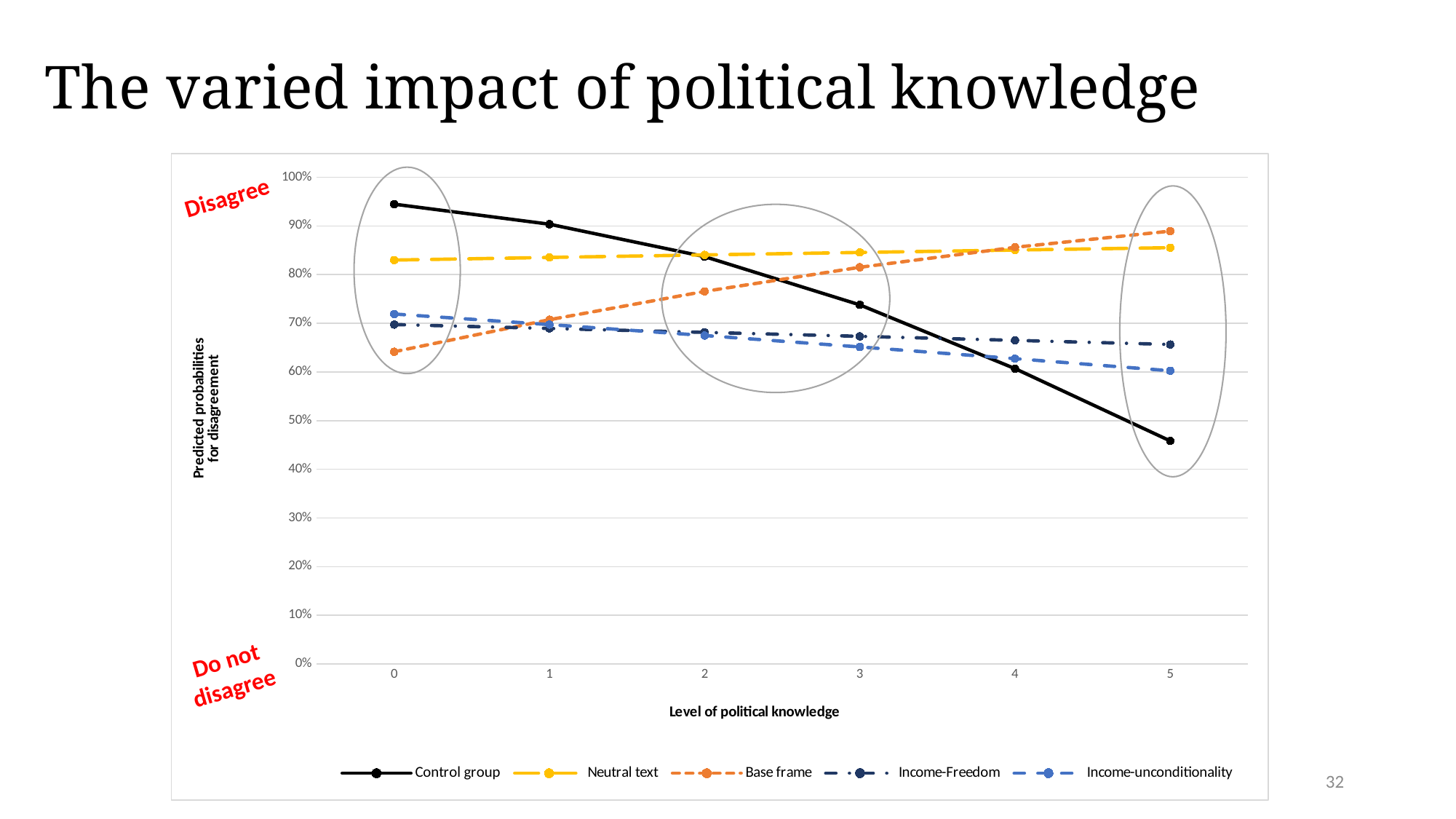
At political knowledge level 0, which is larger: the Control group or the Base frame? Control group How many levels of political knowledge are plotted along the x axis? 6 Does the Control group line rise or fall as the level of political knowledge increases? falls How many series does the legend list? 5 Is the value for the Control group at political knowledge level 5 greater or less than 50%? less Is the value for Base frame at political knowledge level 0 greater or less than 70%? less Does the Base frame line rise or fall as the level of political knowledge increases? rises Which series has the highest value at political knowledge level 5? Base frame What kind of chart is shown on the slide? line chart What is the title of the x axis? Level of political knowledge Is the value for the Control group at political knowledge level 0 greater or less than 90%? greater Which series has the lowest value at political knowledge level 5? Control group